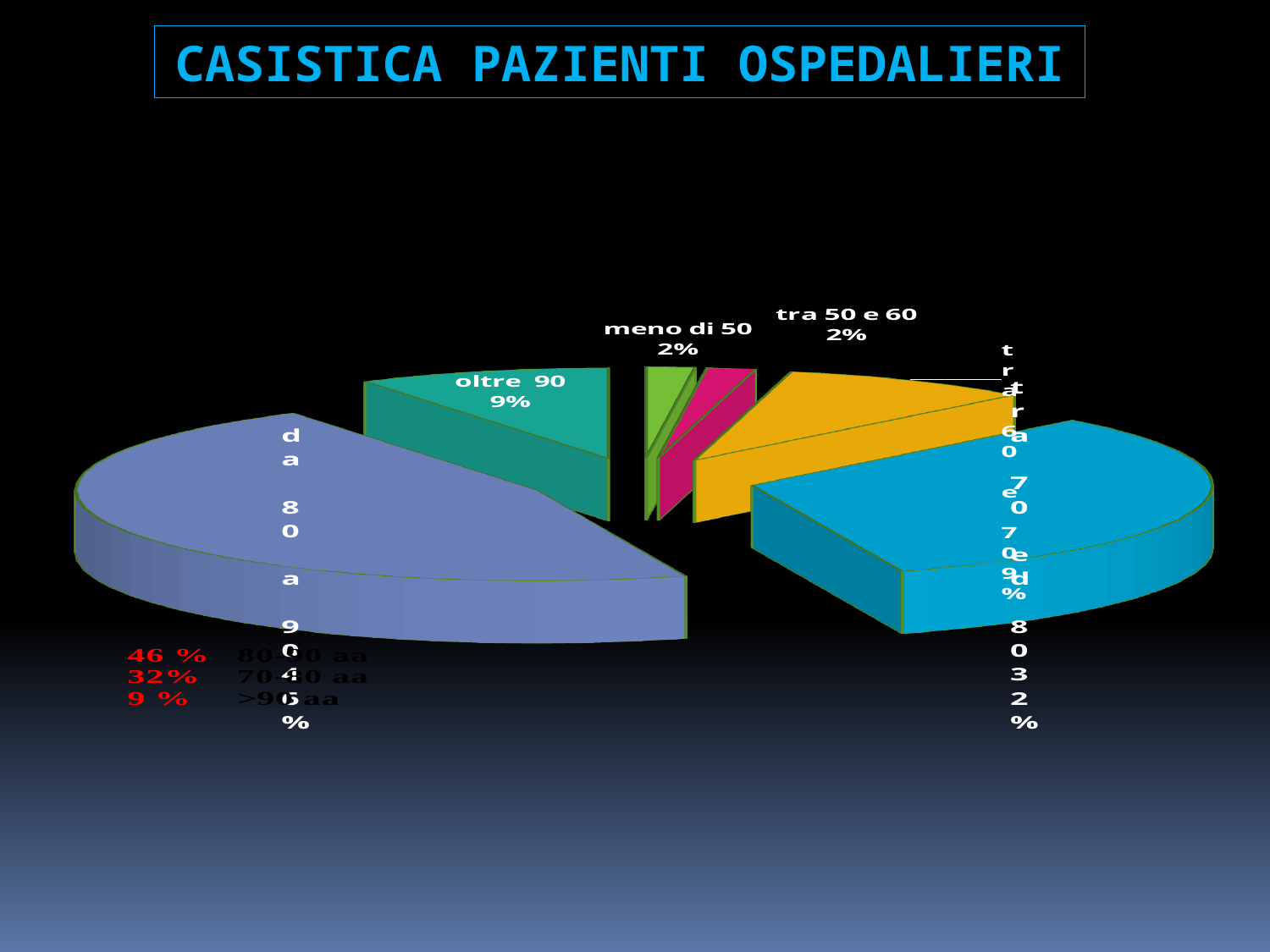
What percentage of patients are in the 'tra 50 e 60' category? 2% Is the share for 'da 80 a 90' greater or less than 40%? greater What percentage of patients are in the 'oltre 90' category? 9% What colour is the 'oltre 90' slice? teal/green How many slices does the pie chart have? 6 What is the title of the chart on the slide? CASISTICA PAZIENTI OSPEDALIERI How many percentage points larger is the 'oltre 90' share than the 'meno di 50' share? 7 What kind of chart is shown on the slide? pie chart What percentage of patients are in the 'meno di 50' category? 2% Which is larger, the share for 'oltre 90' or the share for 'meno di 50'? oltre 90 What percentage of patients are in the 'da 80 a 90' category? 46% Which age category has the largest share of the pie? da 80 a 90